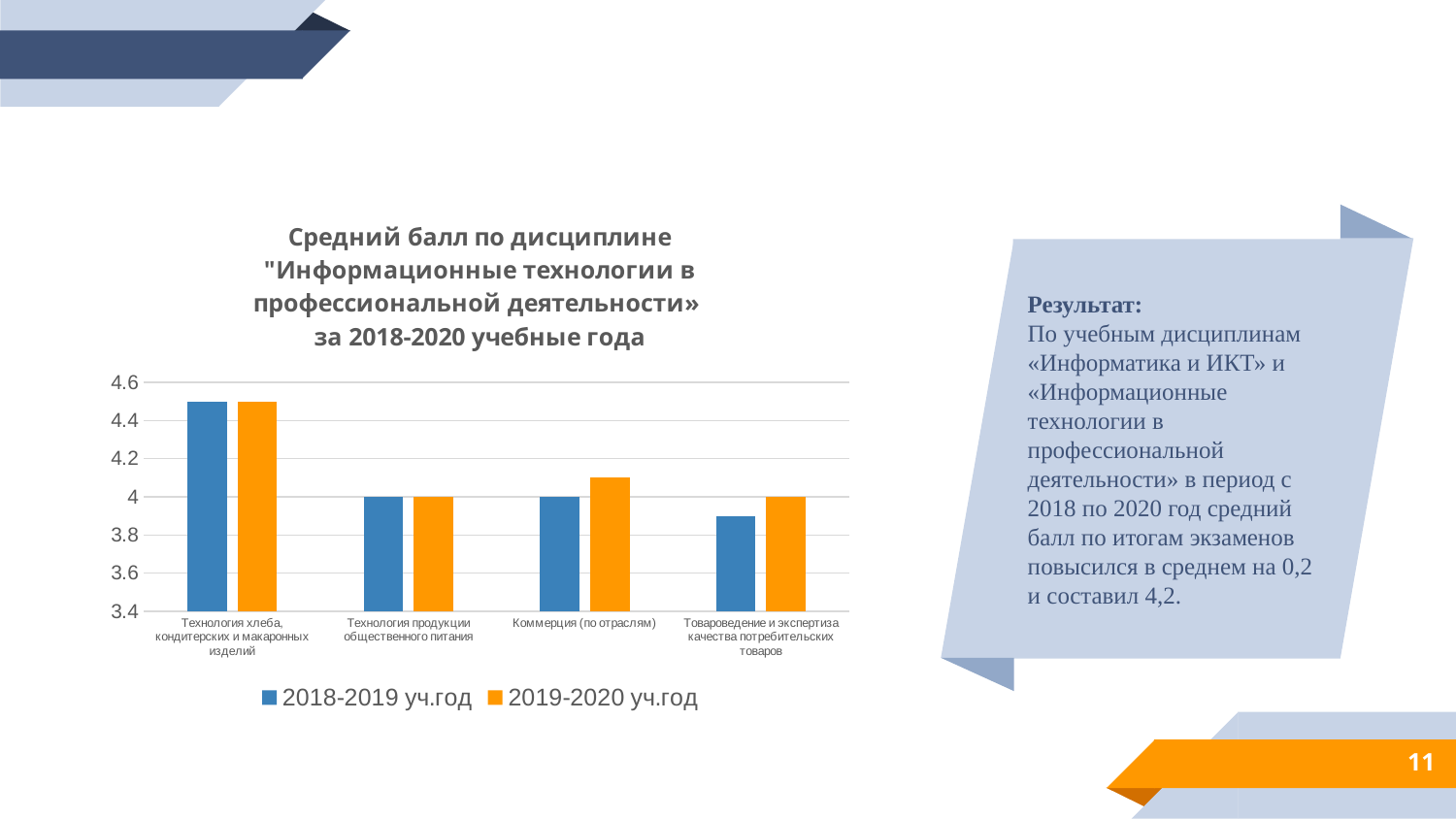
How many categories are shown on the x axis? 4 What kind of chart is shown on the slide? bar chart Is the value for Технология хлеба, кондитерских и макаронных изделий in 2019-2020 уч.год greater or less than 4.4? greater Which category has the highest value in 2019-2020 уч.год? Технология хлеба, кондитерских и макаронных изделий Is the value for Товароведение и экспертиза качества потребительских товаров in 2018-2019 уч.год greater or less than 4? less How many series does the legend list? 2 Which colour represents 2019-2020 уч.год in the legend? orange What is the value for Технология продукции общественного питания in 2018-2019 уч.год? 4 For Коммерция (по отраслям), which series has the larger value, 2018-2019 уч.год or 2019-2020 уч.год? 2019-2020 уч.год Which category has the lowest value in 2018-2019 уч.год? Товароведение и экспертиза качества потребительских товаров What is the value for Товароведение и экспертиза качества потребительских товаров in 2019-2020 уч.год? 4 What is the value for Коммерция (по отраслям) in 2018-2019 уч.год? 4